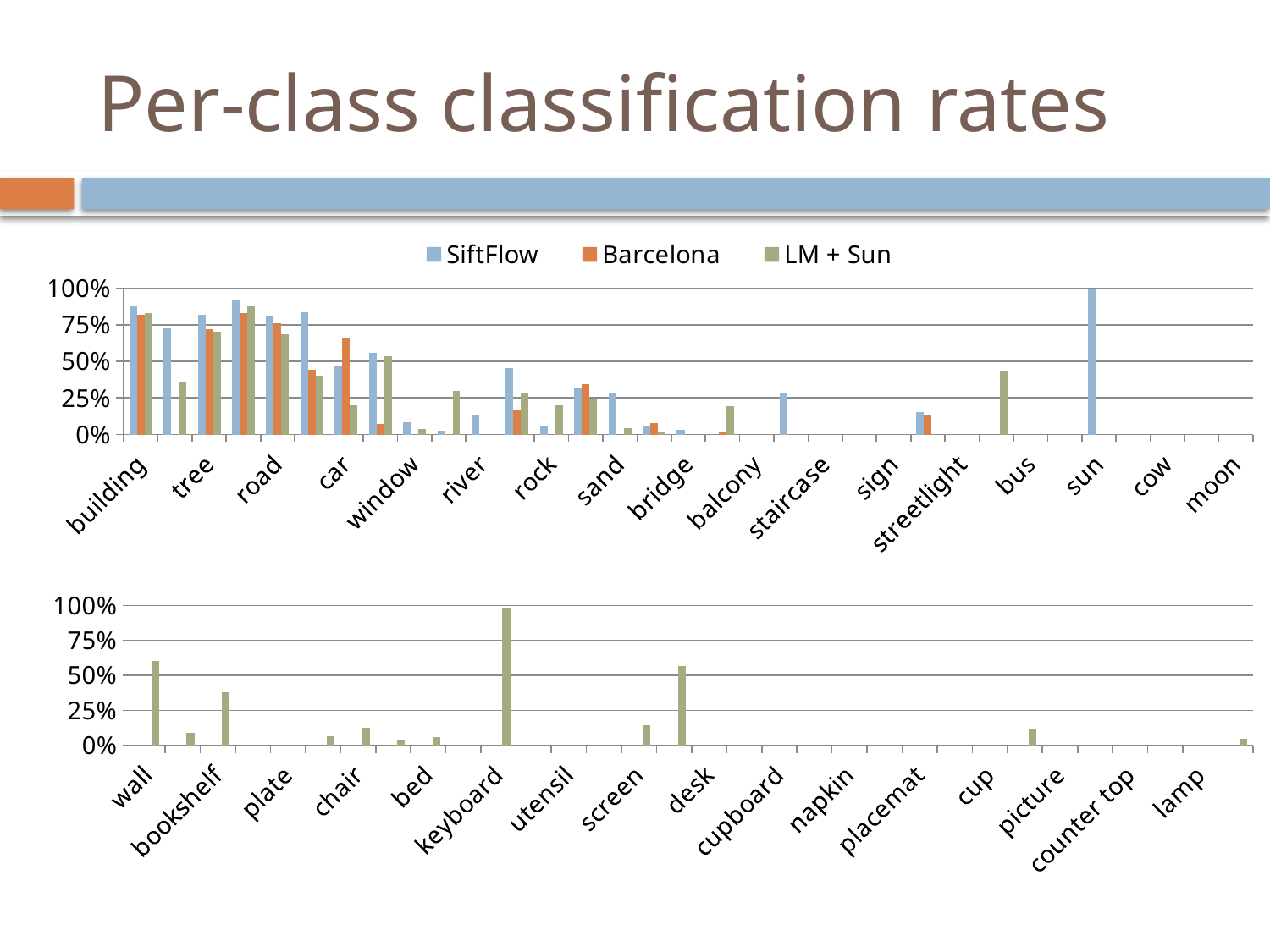
In the bottom chart, which category has the highest value? keyboard How many series does the legend of the top chart list? 3 What are the series names in the legend of the top chart? SiftFlow, Barcelona, LM + Sun In the top chart, is the SiftFlow value for building greater or less than 75%? greater In the top chart, which is larger for car: the SiftFlow value or the Barcelona value? Barcelona What kind of chart is the top chart on the slide? bar chart In the bottom chart, which is larger: the value for wall or the value for bookshelf? wall In the top chart, which is larger for car: the SiftFlow value or the LM + Sun value? SiftFlow In the bottom chart, is the value for wall greater or less than 50%? greater In the top chart, which category has the highest SiftFlow value? sun In the top chart, is the Barcelona value for car greater or less than 50%? greater